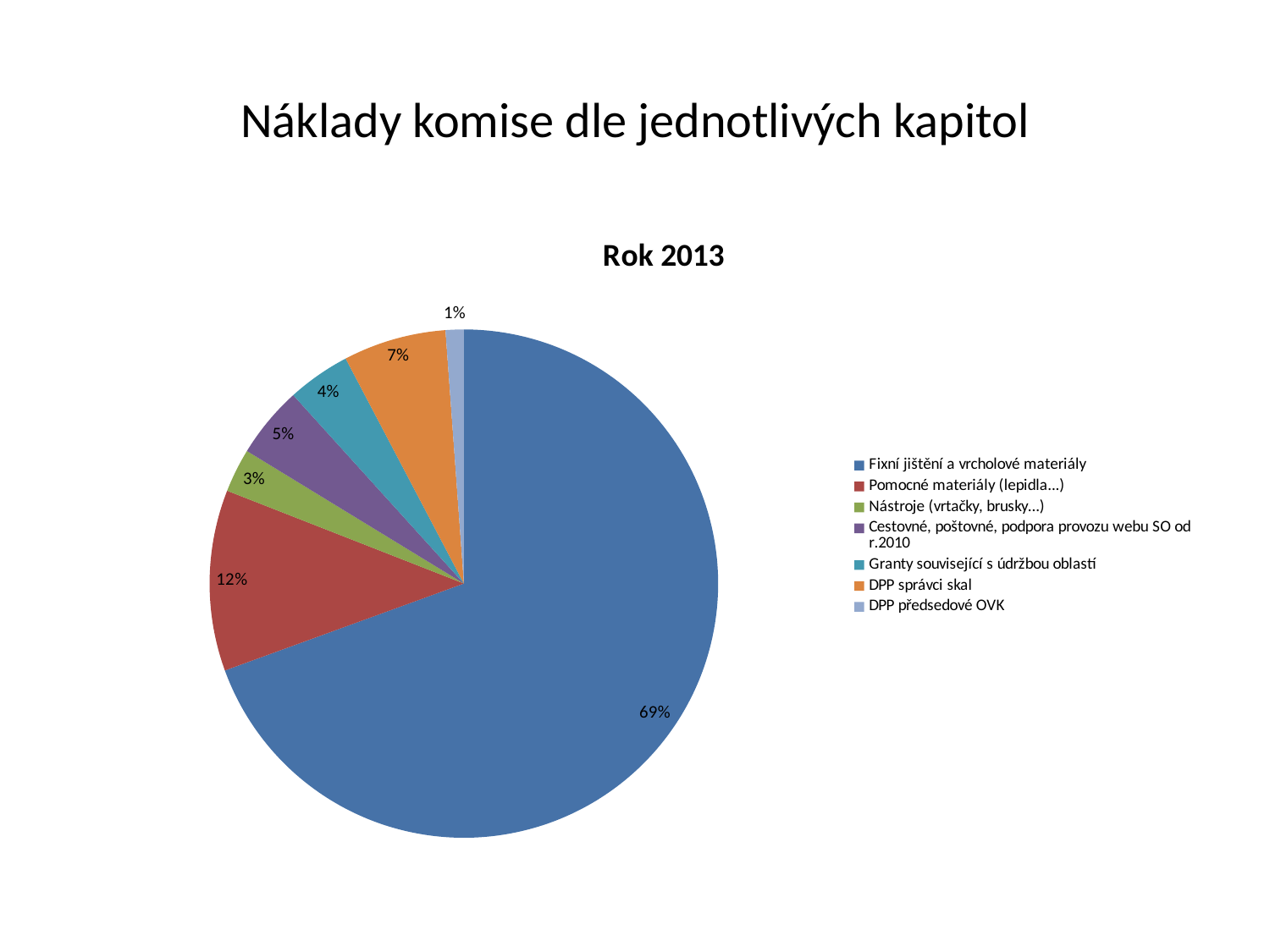
What kind of chart is shown on the slide? pie chart What share of the pie is 'Nástroje (vrtačky, brusky…)'? 3% What is the difference in percentage points between 'Pomocné materiály (lepidla…)' and 'DPP správci skal'? 5 How many slices does the pie chart have? 7 Which category has the largest share of the pie? Fixní jištění a vrcholové materiály What share of the pie is 'Pomocné materiály (lepidla…)'? 12% What is the title of the chart? Rok 2013 Which is larger: the share for 'Cestovné, poštovné, podpora provozu webu SO od r.2010' or the share for 'Granty související s údržbou oblastí'? Cestovné, poštovné, podpora provozu webu SO od r.2010 Which category is shown in orange in the legend? DPP správci skal Which category has the smallest share of the pie? DPP předsedové OVK What share of the pie is 'Fixní jištění a vrcholové materiály'? 69%